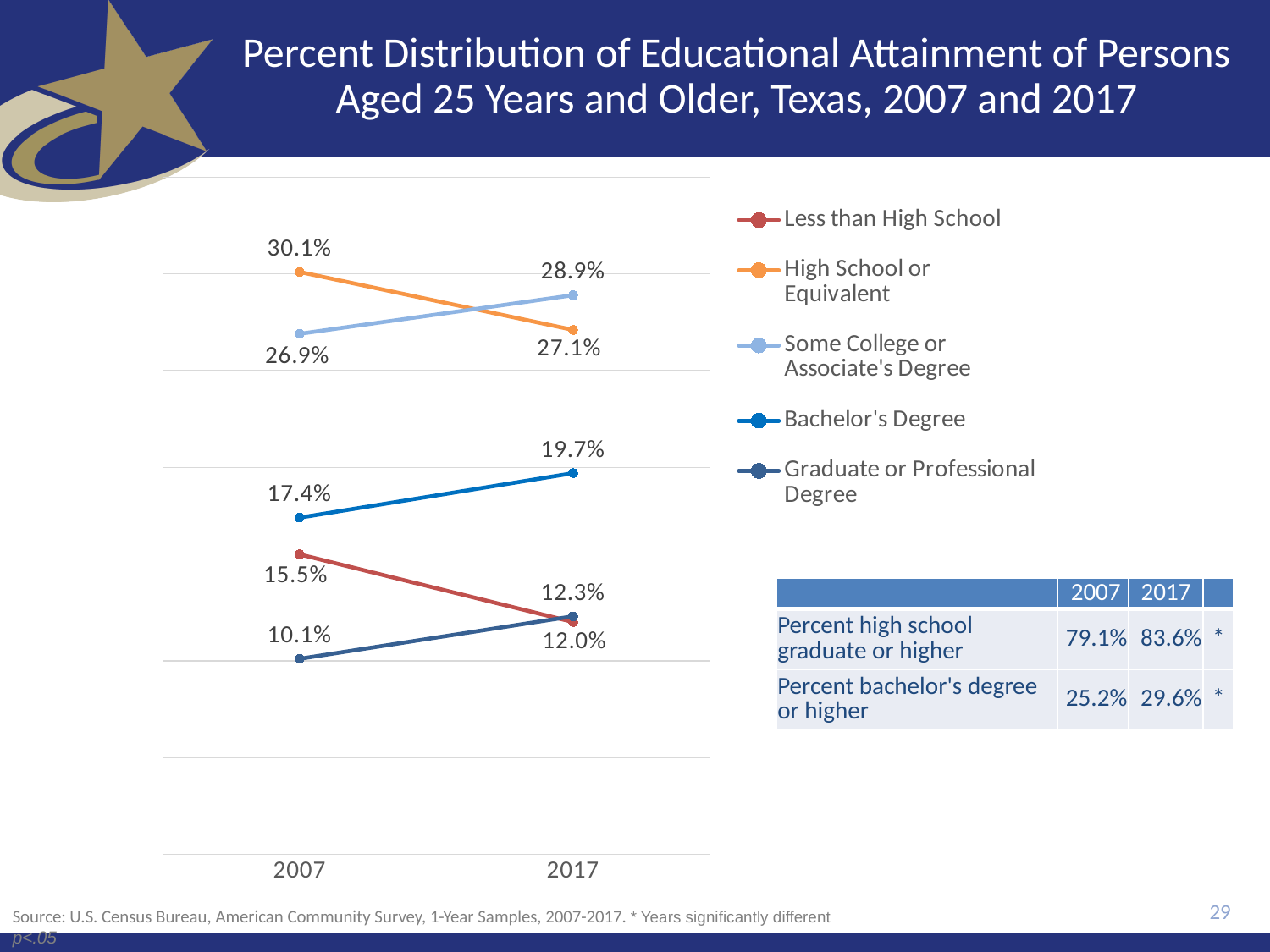
What is the value for Graduate or Professional Degree in 2007? 10.1% What is the value for High School or Equivalent in 2007? 30.1% What is the value for Less than High School in 2017? 12.0% Which series has the highest value in 2007? High School or Equivalent What is the value for Some College or Associate's Degree in 2017? 28.9% Which series has the lowest value in 2017? Less than High School What is the difference between the Bachelor's Degree values in 2017 and 2007? 2.3% How many series does the legend list? 5 How many years are shown on the x axis? 2 Does the Less than High School series rise or fall from 2007 to 2017? fall What type of chart is shown on the slide? line chart Which is larger in 2017: High School or Equivalent or Some College or Associate's Degree? Some College or Associate's Degree